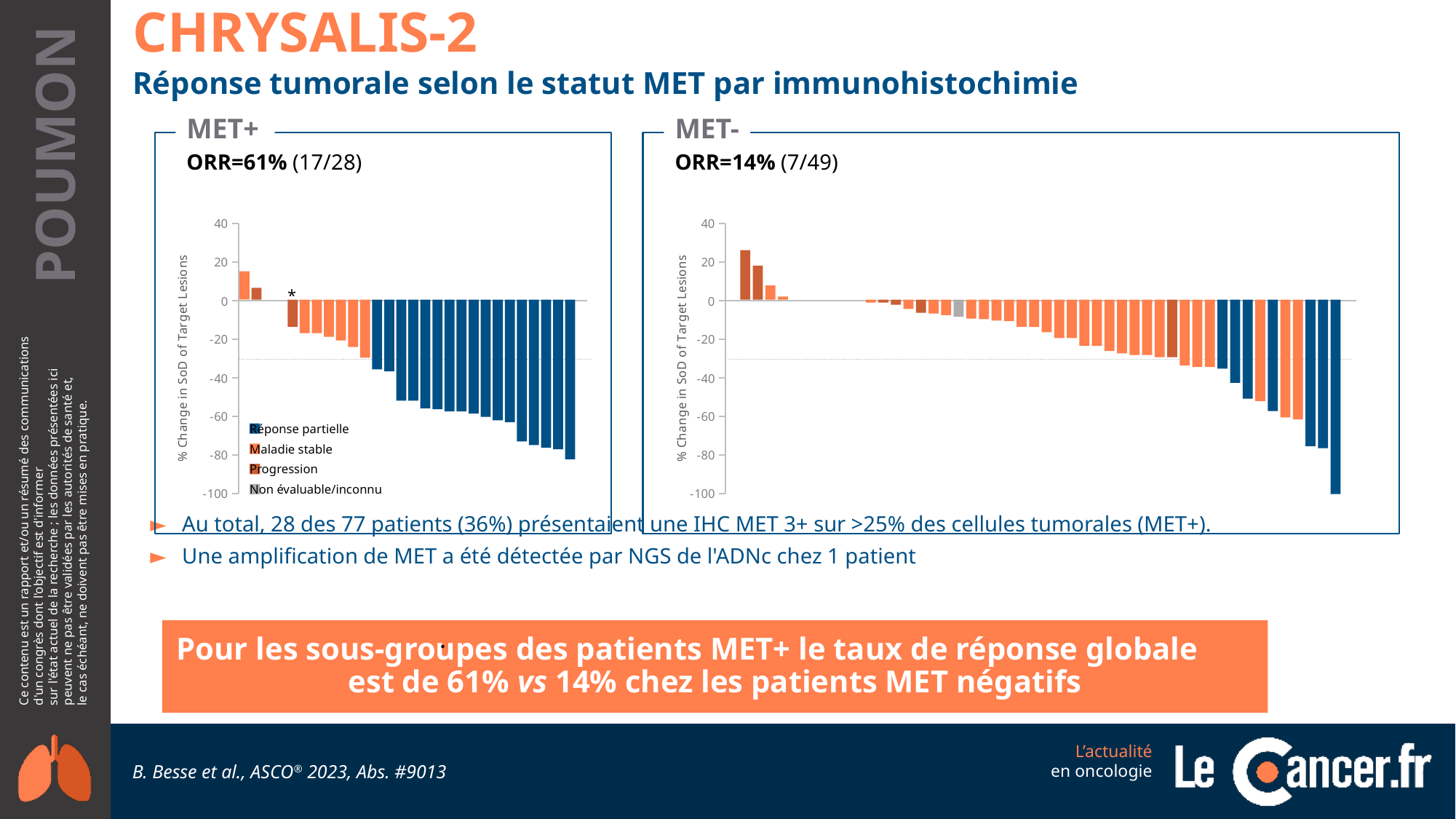
Which group has the higher ORR, MET+ or MET-? MET+ In the MET+ chart, do the bar values rise or fall from left to right? fall How many patients are in the MET- group according to the ORR fraction shown? 49 In the MET+ chart, is the value of the tallest positive bar greater or less than 20? less In the MET- chart, is the value of the tallest positive bar greater or less than 20? greater What is the ORR printed above the MET- chart? 14% What is the ORR printed above the MET+ chart? 61% How many patients are in the MET+ group according to the ORR fraction shown? 28 In the MET- chart, is the value of the lowest bar greater or less than -80? less What is the difference between the ORR of the MET+ group and the ORR of the MET- group? 47% How many entries does the legend in the MET+ chart list? 4 What kind of chart is shown in the MET+ panel? bar chart